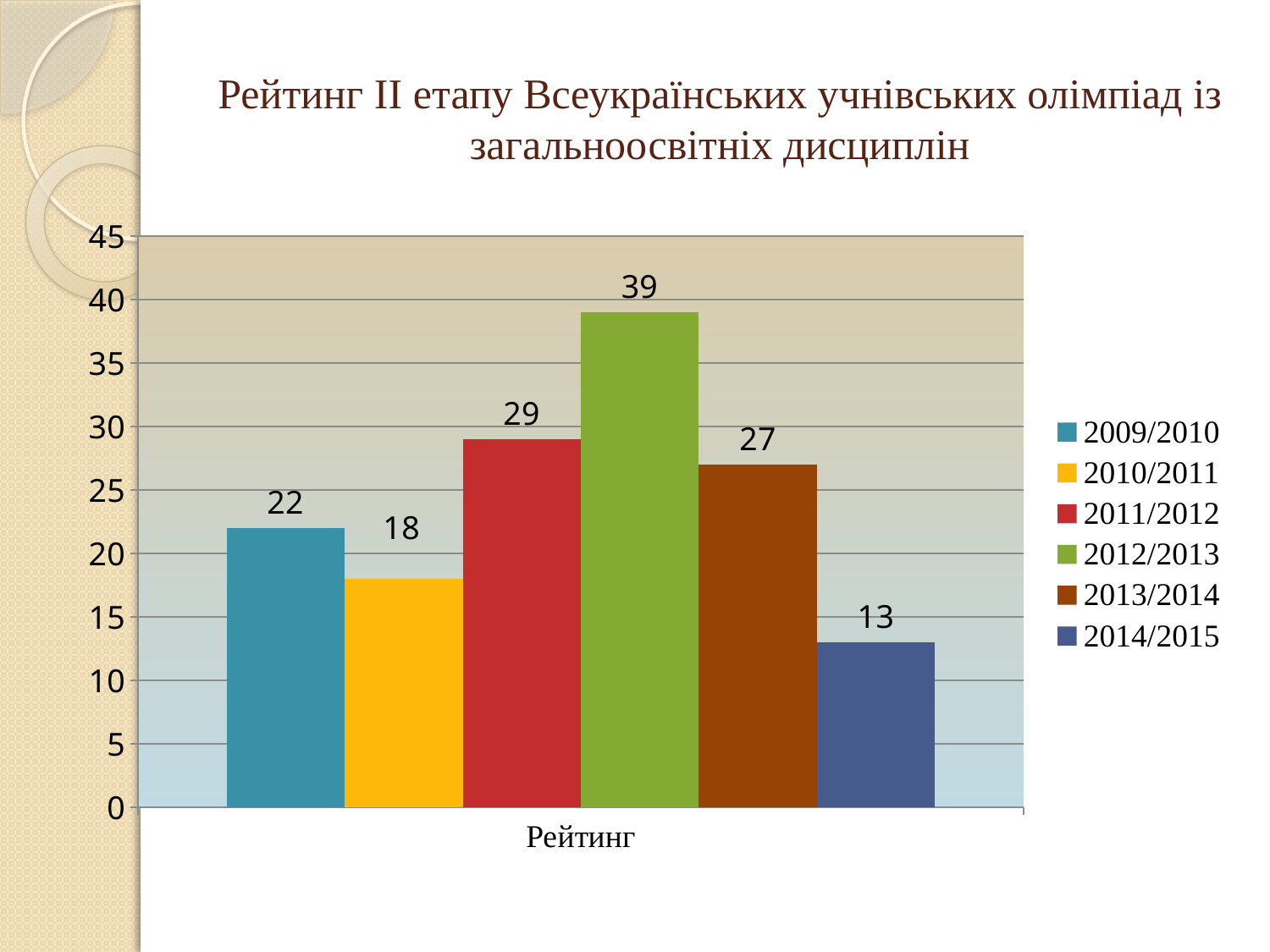
Is the value for 2013/2014 greater or less than 25? greater What is the difference between the values for 2012/2013 and 2014/2015? 26 What is the value for 2009/2010? 22 What is the difference between the values for 2011/2012 and 2010/2011? 11 What is the value for 2012/2013? 39 Which is larger, the value for 2011/2012 or the value for 2013/2014? 2011/2012 What is the value for 2014/2015? 13 What kind of chart is shown on the slide? bar chart What is the label on the x axis of the chart? Рейтинг How many series does the legend list? 6 Which series has the highest value? 2012/2013 Which series has the lowest value? 2014/2015